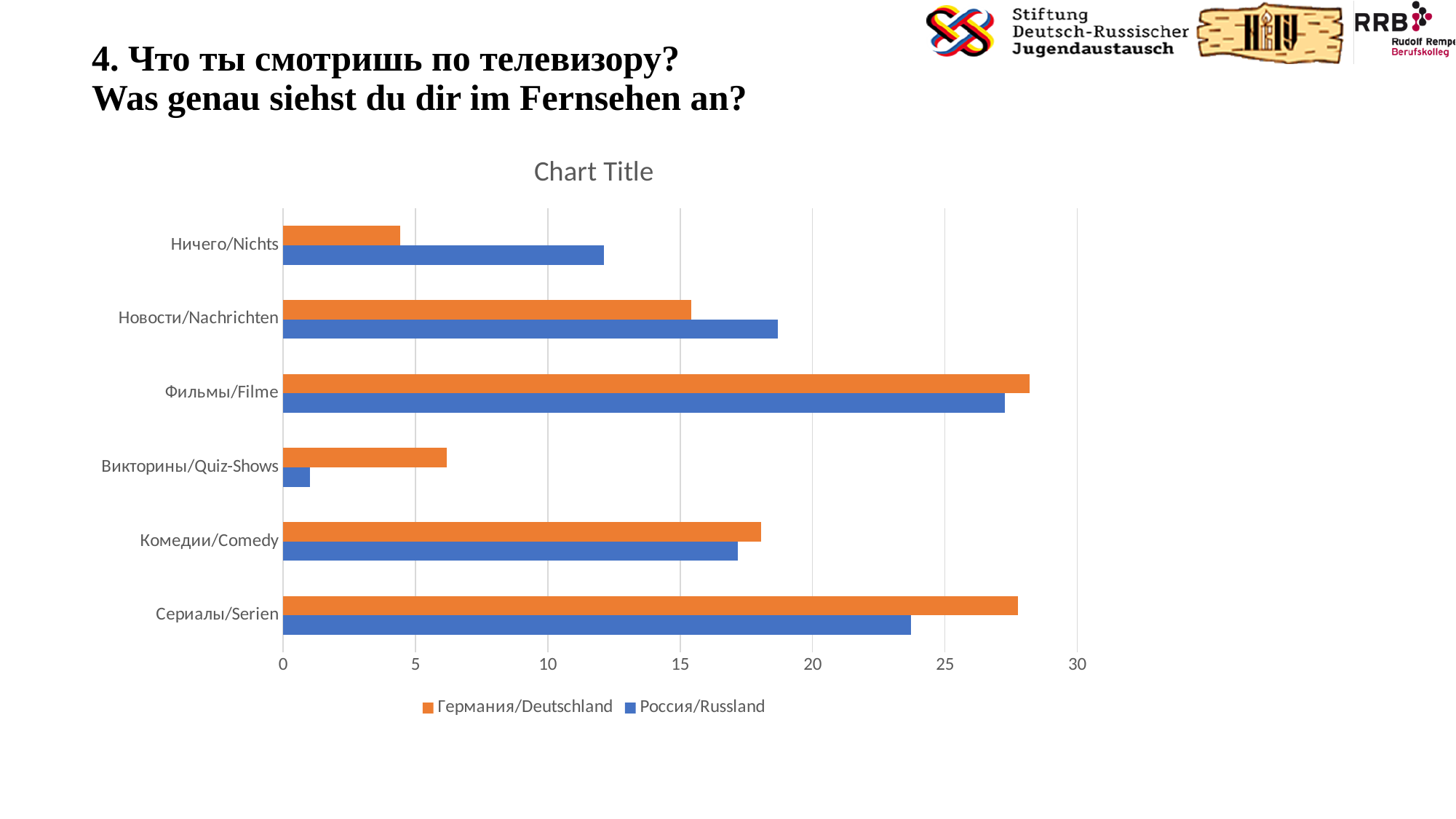
For Ничего/Nichts, which series has the larger value, Германия/Deutschland or Россия/Russland? Россия/Russland What is the title shown above the chart? Chart Title What kind of chart is shown on the slide? bar chart How many categories are shown on the chart? 6 For Сериалы/Serien, which series has the larger value, Германия/Deutschland or Россия/Russland? Германия/Deutschland Which category has the lowest value for Германия/Deutschland? Ничего/Nichts Which category has the highest value for Россия/Russland? Фильмы/Filme How many series does the legend list? 2 Is the value for Россия/Russland in Ничего/Nichts greater or less than 10? greater Which category has the lowest value for Россия/Russland? Викторины/Quiz-Shows For Викторины/Quiz-Shows, which series has the larger value, Германия/Deutschland or Россия/Russland? Германия/Deutschland Is the value for Россия/Russland in Сериалы/Serien greater or less than 25? less